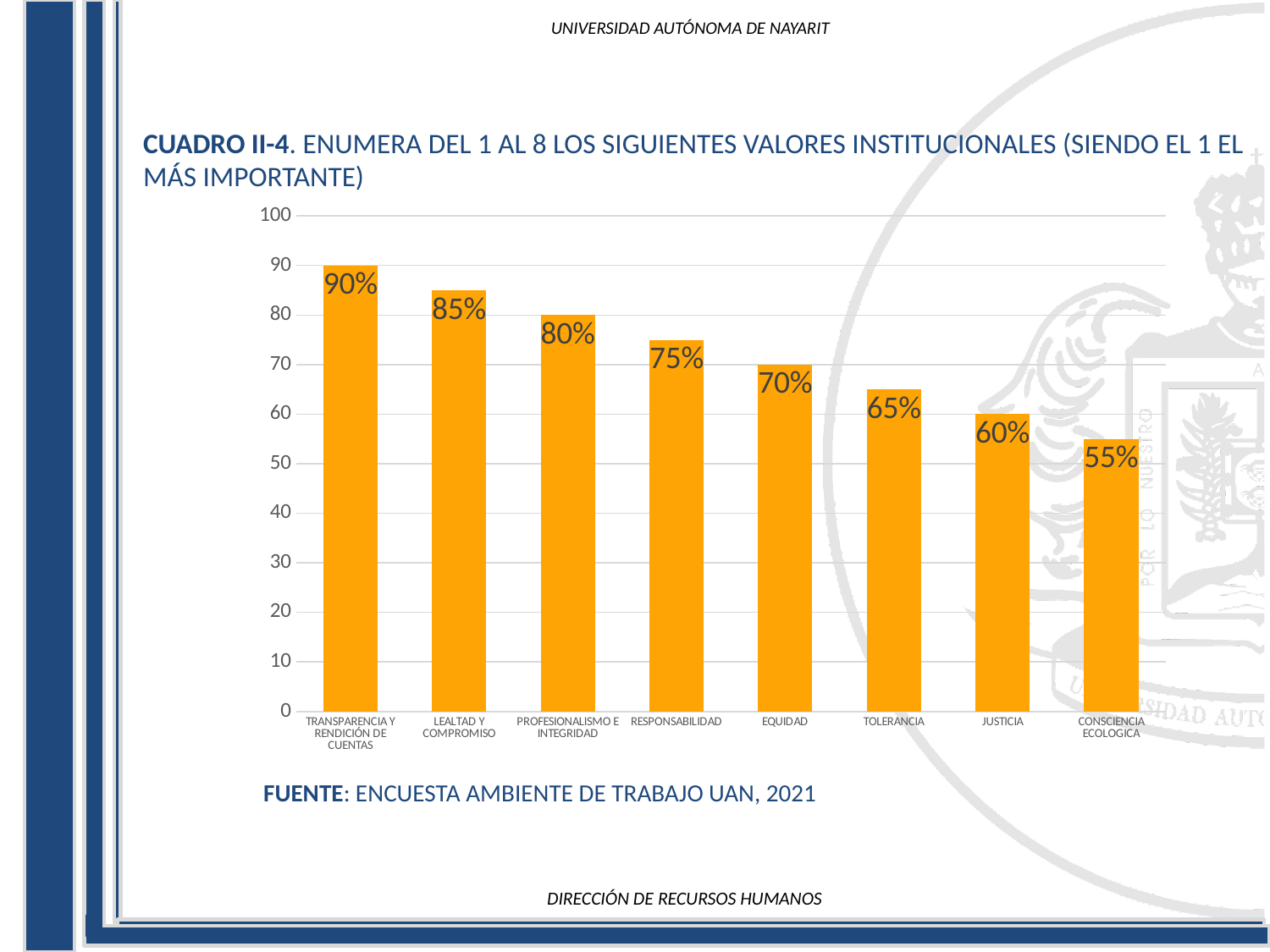
What is the difference between the values for RESPONSABILIDAD and TOLERANCIA? 10% What is the value for JUSTICIA? 60% Which category has the highest value? TRANSPARENCIA Y RENDICIÓN DE CUENTAS What source is cited below the chart? ENCUESTA AMBIENTE DE TRABAJO UAN, 2021 How many categories are shown in the chart? 8 What is the value for LEALTAD Y COMPROMISO? 85% Do the values rise or fall from left to right along the x axis? fall What kind of chart is shown on the slide? bar chart Which category has the lowest value? CONSCIENCIA ECOLOGICA Is the value for TOLERANCIA greater or less than 70? less What is the value for EQUIDAD? 70% Which is larger, the value for PROFESIONALISMO E INTEGRIDAD or the value for EQUIDAD? PROFESIONALISMO E INTEGRIDAD